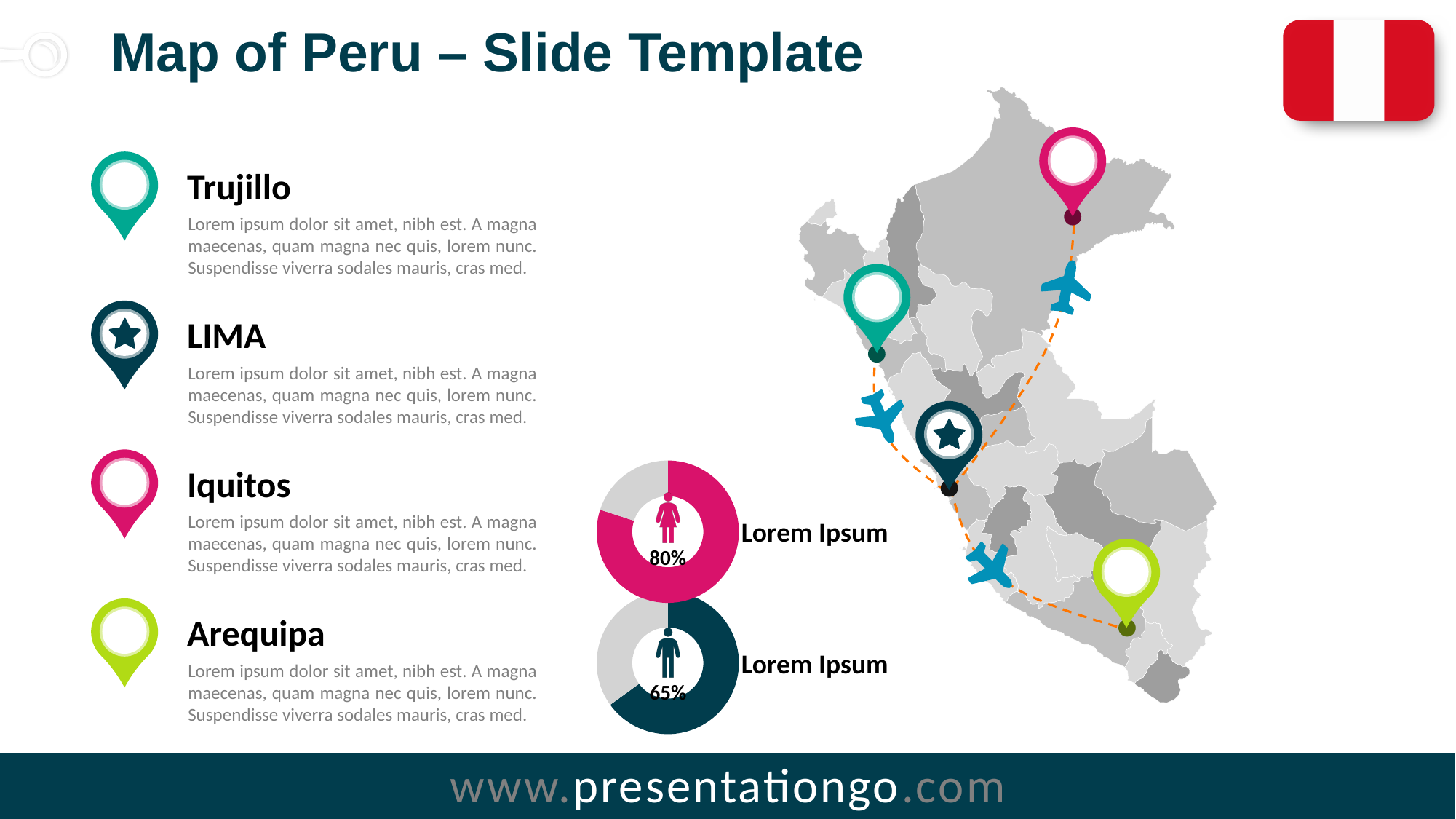
What kind of chart is used to display the 80% and 65% values? Donut (pie) chart What is the difference between the percentages shown in the upper and lower donut charts? 15 percentage points What percentage is shown in the upper (pink) donut chart? 80% Is the value shown in the upper donut chart greater or less than 50%? greater What icon appears in the centre of the upper donut chart? A female figure How many donut charts are on the slide? 2 What percentage is shown in the lower (dark blue) donut chart? 65% What label text appears to the right of each donut chart? Lorem Ipsum What share of the upper donut chart is left unfilled (grey)? 20% Which donut chart shows the larger percentage, the upper pink one or the lower dark blue one? The upper pink one Is the value shown in the lower donut chart greater or less than 75%? less What share of the lower donut chart is left unfilled (grey)? 35%